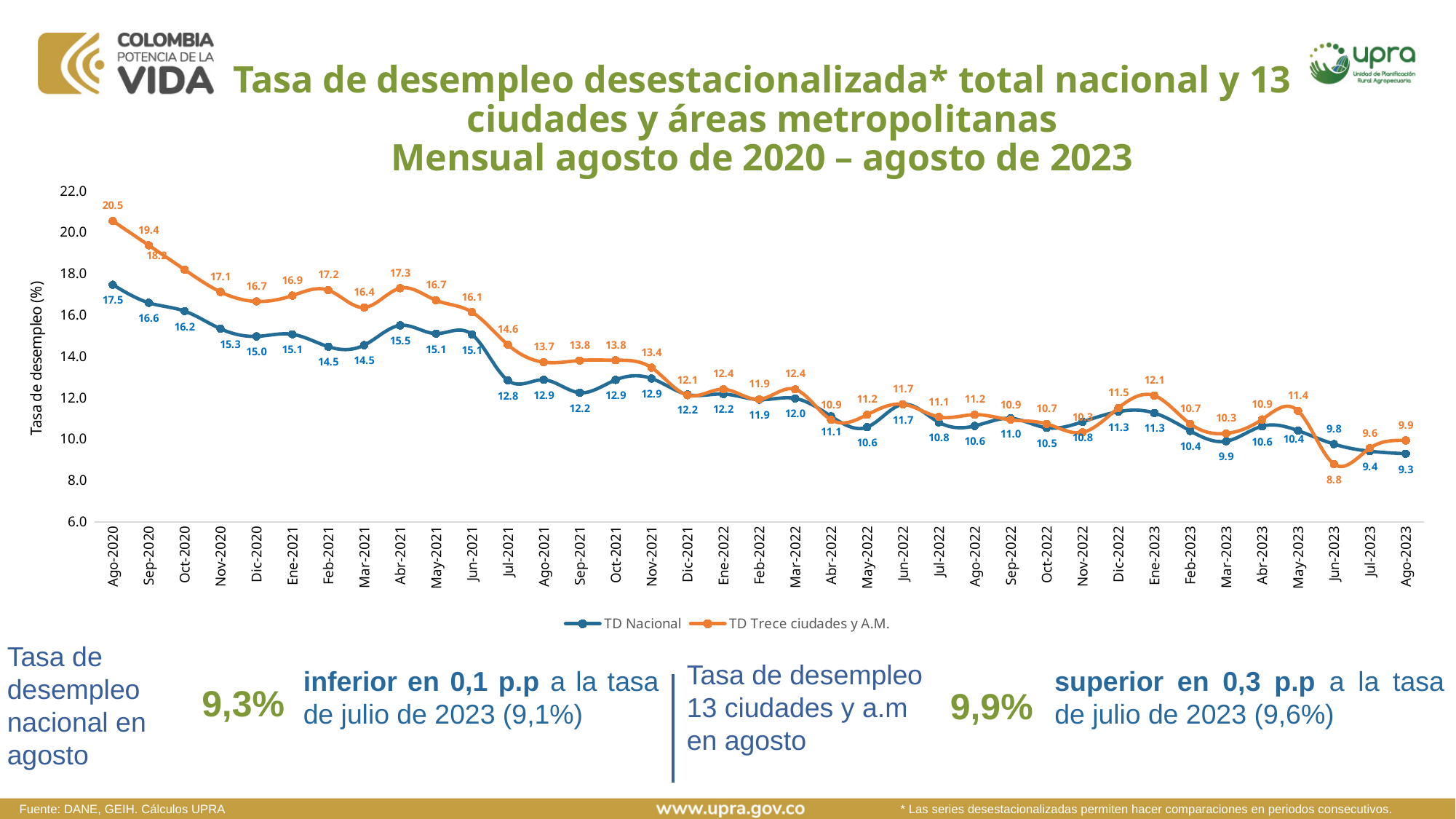
What is the difference between TD Trece ciudades y A.M. and TD Nacional in Ago-2023? 0.6 In Jun-2023, which series has the higher value, TD Nacional or TD Trece ciudades y A.M.? TD Nacional What is the label of the vertical axis? Tasa de desempleo (%) What kind of chart is shown on the slide? Line chart Do the TD Nacional values generally rise or fall from Ago-2020 to Ago-2023? Fall How many series does the legend list? 2 What is the value of TD Trece ciudades y A.M. for Ago-2020? 20.5 In which month does TD Nacional reach its lowest value? Ago-2023 In which month does TD Trece ciudades y A.M. reach its lowest value? Jun-2023 In which month does TD Trece ciudades y A.M. reach its highest value? Ago-2020 What is the value of TD Nacional for Abr-2021? 15.5 What is the value of TD Nacional for Ago-2023? 9.3